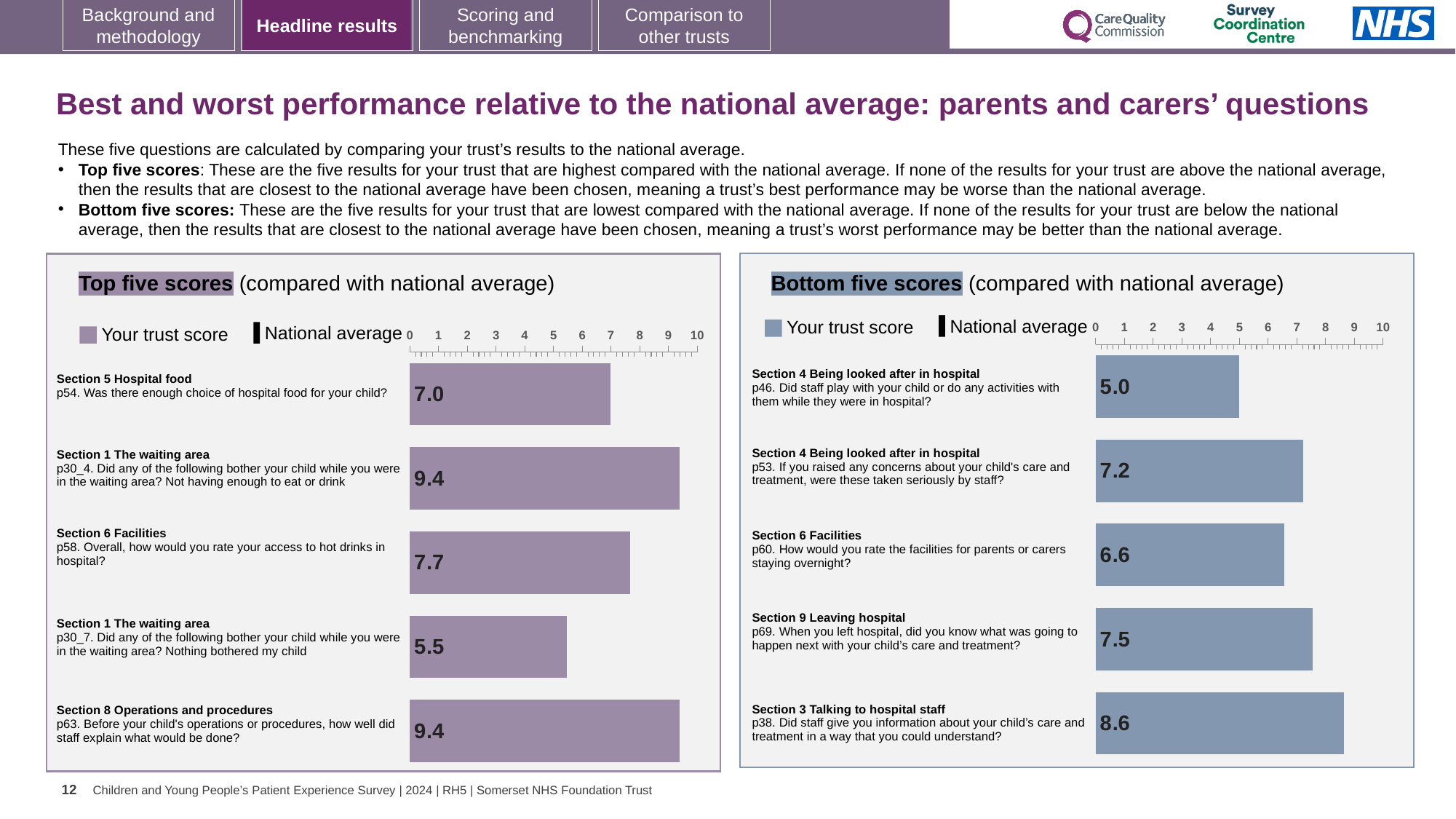
In the 'Bottom five scores' chart, what is the trust score for p60 (facilities for parents or carers staying overnight)? 6.6 In the 'Top five scores' chart, how many questions are plotted? 5 In the 'Top five scores' chart, what is the trust score for p58 (access to hot drinks in hospital)? 7.7 In the 'Bottom five scores' chart, which question has the highest trust score? p38. Did staff give you information about your child's care and treatment in a way that you could understand? In the 'Bottom five scores' chart, which has the larger trust score: p53 or p69? p69 What type of chart is the 'Top five scores' chart? Bar chart In the 'Bottom five scores' chart, which question has the lowest trust score? p46. Did staff play with your child or do any activities with them while they were in hospital? In the 'Bottom five scores' chart, what is the trust score for p46 (Did staff play with your child or do any activities with them while they were in hospital?)? 5.0 In the 'Top five scores' chart, what is the trust score for p54 (Was there enough choice of hospital food for your child?)? 7.0 In the 'Bottom five scores' chart, what is the difference between the trust scores for p38 and p46? 3.6 In the 'Top five scores' chart, which question has the lowest trust score? p30_7. Nothing bothered my child In the 'Top five scores' chart, what is the difference between the trust scores for p30_4 and p30_7? 3.9